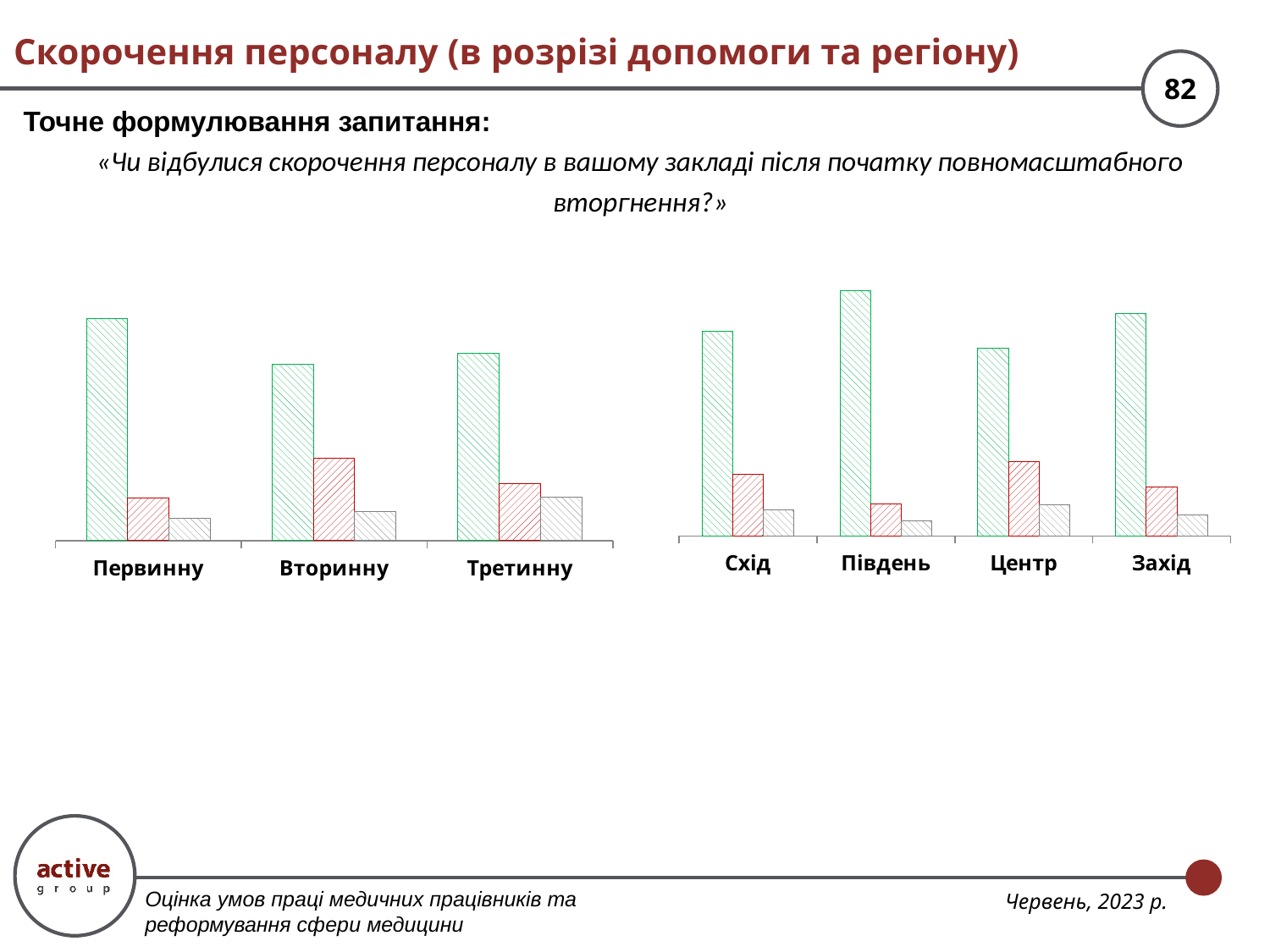
In the left chart, which category has the shortest green hatched bar? Вторинну How many categories are shown on the x axis of the right chart? 4 What kind of chart is the right chart (Схід, Південь, Центр, Захід)? bar chart How many categories are shown on the x axis of the left chart? 3 In the left chart, which category has the tallest red hatched bar? Вторинну In the right chart, which region has the tallest green hatched bar? Південь What kind of chart is the left chart (Первинну, Вторинну, Третинну)? bar chart How many bars are shown for each category in the left chart? 3 In the right chart, is the green bar for Південь taller or shorter than the green bar for Центр? taller In the right chart, which region has the shortest red hatched bar? Південь In the left chart, which category has the tallest green hatched bar? Первинну